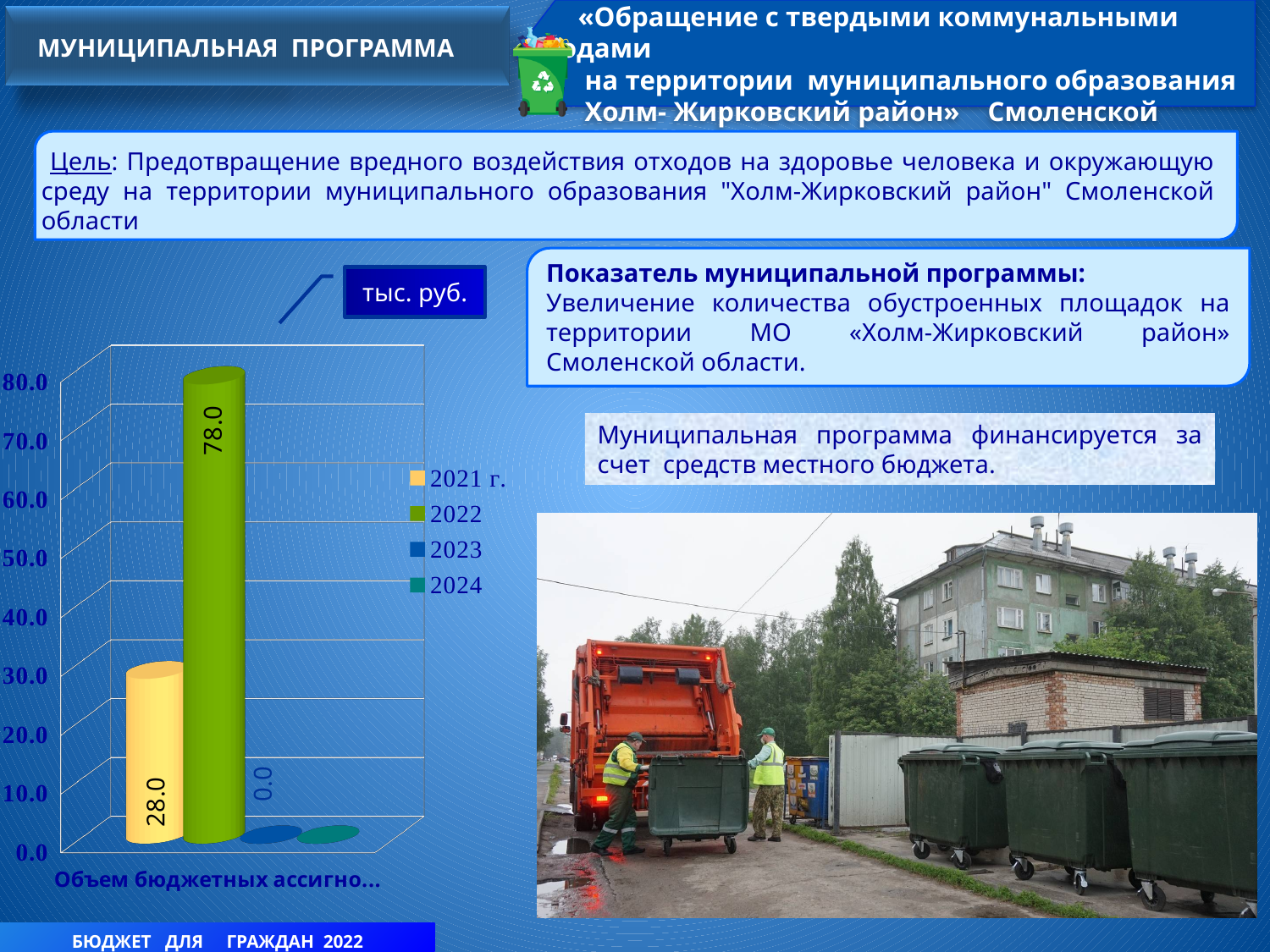
Is the value for 2022 greater or less than 70.0? greater What kind of chart is shown on the slide? bar chart What is the difference between the values for 2022 and 2021 г.? 50.0 What is the value for 2022 in the chart? 78.0 What is the value for 2023 in the chart? 0.0 What unit is indicated for the chart values? тыс. руб. Is the value for 2021 г. greater or less than 30.0? less Which is larger, the value for 2021 г. or the value for 2022? 2022 What colour is the bar for 2022 in the chart? green Which year has the highest value in the chart? 2022 What is the value for 2021 г. in the chart? 28.0 How many series does the chart legend list? 4